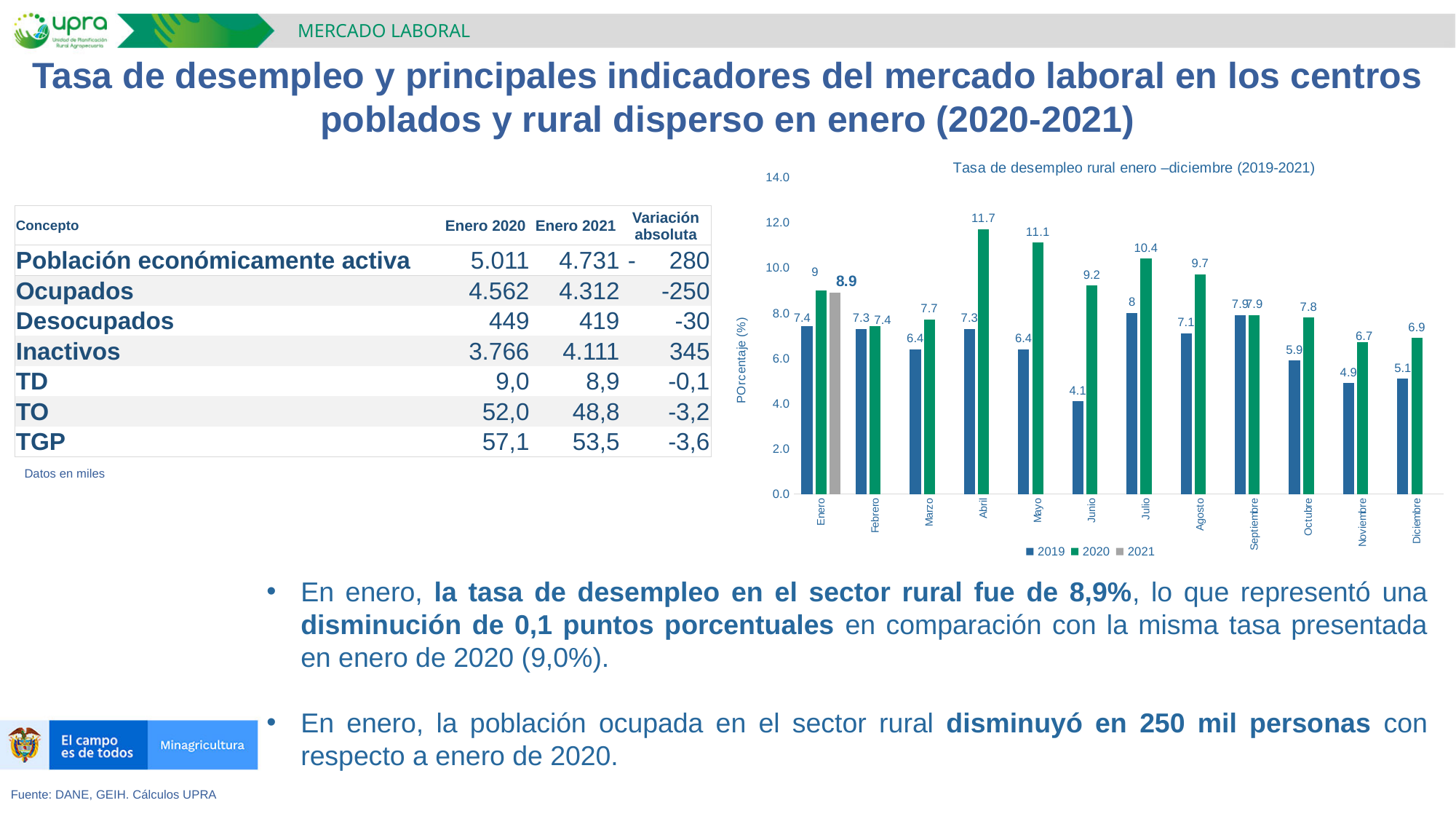
Which is larger for Octubre: the 2019 value or the 2020 value? 2020 Which month has the lowest 2019 value in the chart? Junio What is the 2021 value for Enero in the chart? 8.9 Is the 2020 value for Julio greater or less than 10.0? greater How many months are shown on the x axis of the chart? 12 Which month has the highest 2020 value in the chart? Abril What type of chart is shown on the slide? bar chart What is the 2020 value for Abril in the chart? 11.7 What is the 2019 value for Junio in the chart? 4.1 How many series does the chart legend list? 3 What is the difference between the 2020 and 2019 values for Mayo? 4.7 What is the title of the chart? Tasa de desempleo rural enero –diciembre (2019-2021)